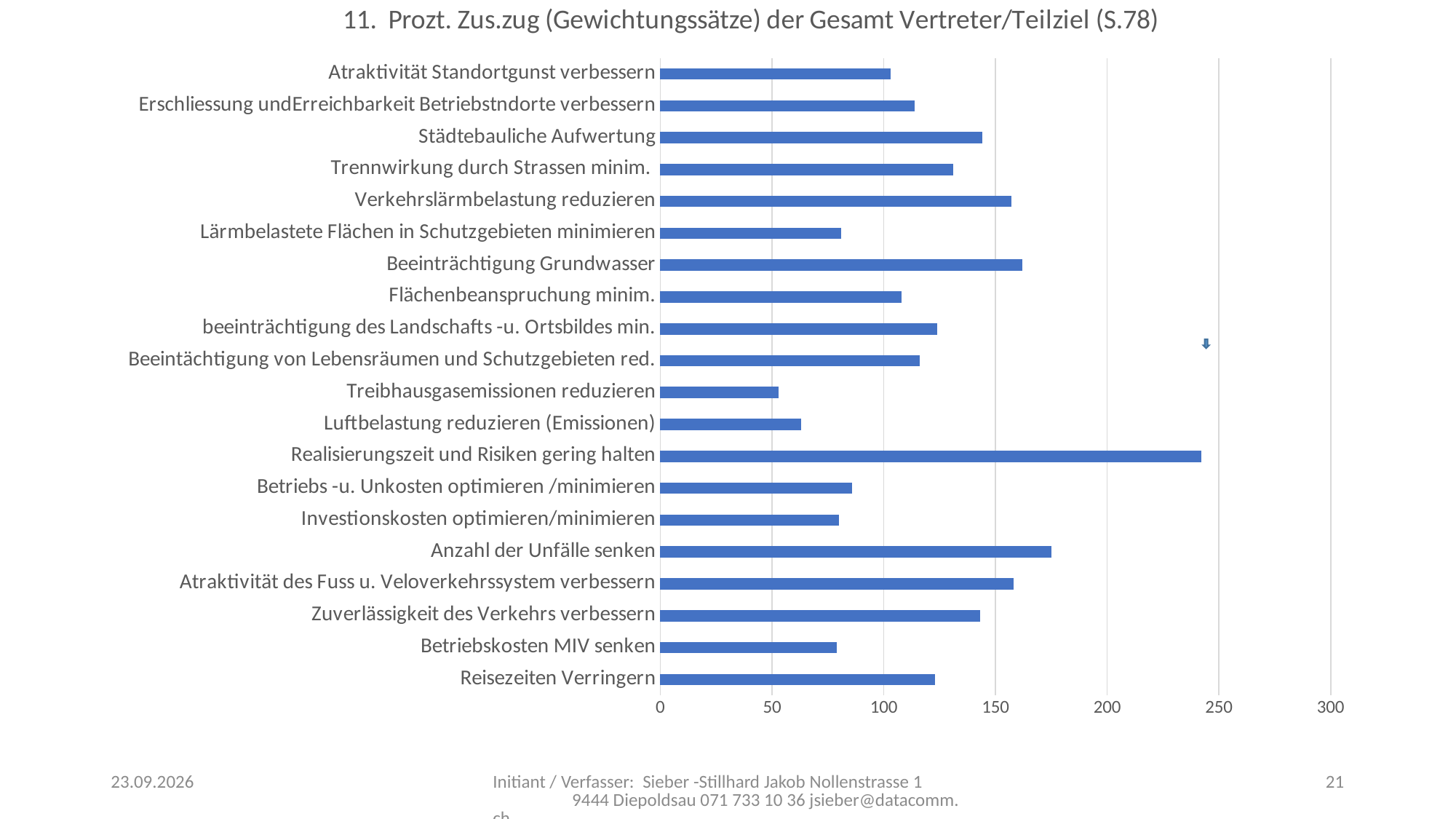
What kind of chart is shown on the slide? bar chart Which category has the lowest value in the chart? Treibhausgasemissionen reduzieren Is the value for Anzahl der Unfälle senken greater or less than 150? greater Is the value for Beeinträchtigung Grundwasser greater or less than 150? greater How many categories are plotted in the chart? 20 What is the title of the chart? 11. Prozt. Zus.zug (Gewichtungssätze) der Gesamt Vertreter/Teilziel (S.78) Is the value for Realisierungszeit und Risiken gering halten greater or less than 200? greater Which category has the highest value in the chart? Realisierungszeit und Risiken gering halten Which has the larger value: Luftbelastung reduzieren (Emissionen) or Städtebauliche Aufwertung? Städtebauliche Aufwertung Which has the larger value: Anzahl der Unfälle senken or Investionskosten optimieren/minimieren? Anzahl der Unfälle senken